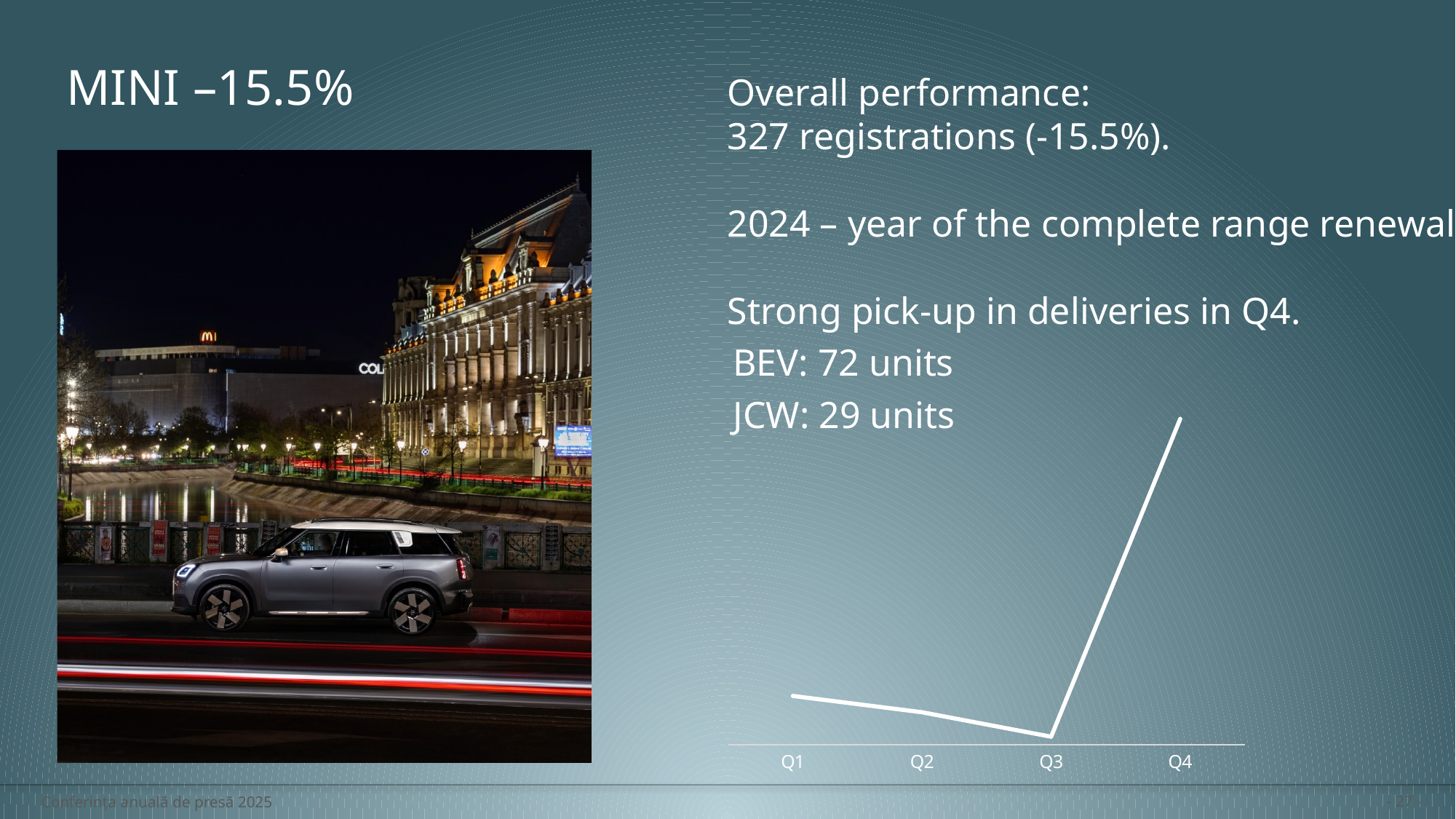
What colour is the line in the chart? white How many quarters are plotted on the x axis of the chart? 4 What kind of chart is shown on the slide? line chart Which quarter has the lowest value in the chart? Q3 Does the line rise or fall from Q3 to Q4? rise Is the value for Q4 larger or smaller than the value for Q3? larger Does the line rise or fall from Q1 to Q3? fall What are the category labels on the x axis of the chart? Q1, Q2, Q3, Q4 Which is larger, the value for Q1 or the value for Q2? Q1 Which quarter has the highest value in the chart? Q4 Which is larger, the value for Q1 or the value for Q3? Q1